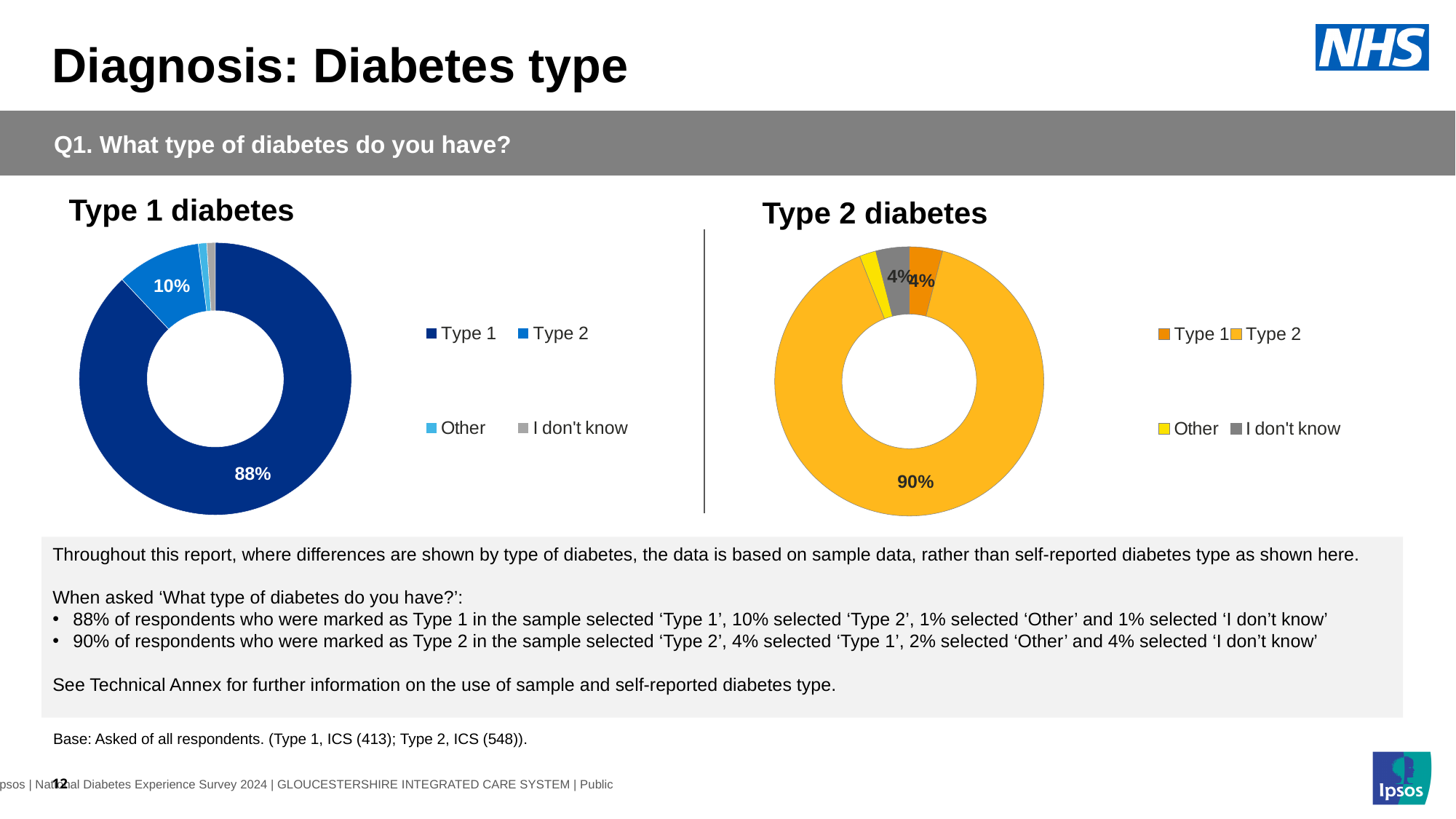
In the Type 2 diabetes chart, what percentage selected 'Type 2'? 90% In the Type 1 diabetes chart, which is larger: the share for 'Type 1' or the share for 'Type 2'? Type 1 In the Type 1 diabetes chart, what percentage selected 'Type 2'? 10% How many charts are shown on the slide? 2 In the Type 1 diabetes chart, what percentage selected 'Type 1'? 88% In the Type 2 diabetes chart, which category has the largest share? Type 2 In the Type 2 diabetes chart, what percentage selected 'Type 1'? 4% In the Type 2 diabetes chart, what is the difference in percentage points between 'Type 2' and 'Type 1'? 86 percentage points In the Type 1 diabetes chart, what is the difference in percentage points between 'Type 1' and 'Type 2'? 78 percentage points How many categories does the legend of the Type 2 diabetes chart list? 4 What kind of chart is used for the Type 1 diabetes data? Donut (pie) chart In the Type 1 diabetes chart, which category has the largest share? Type 1